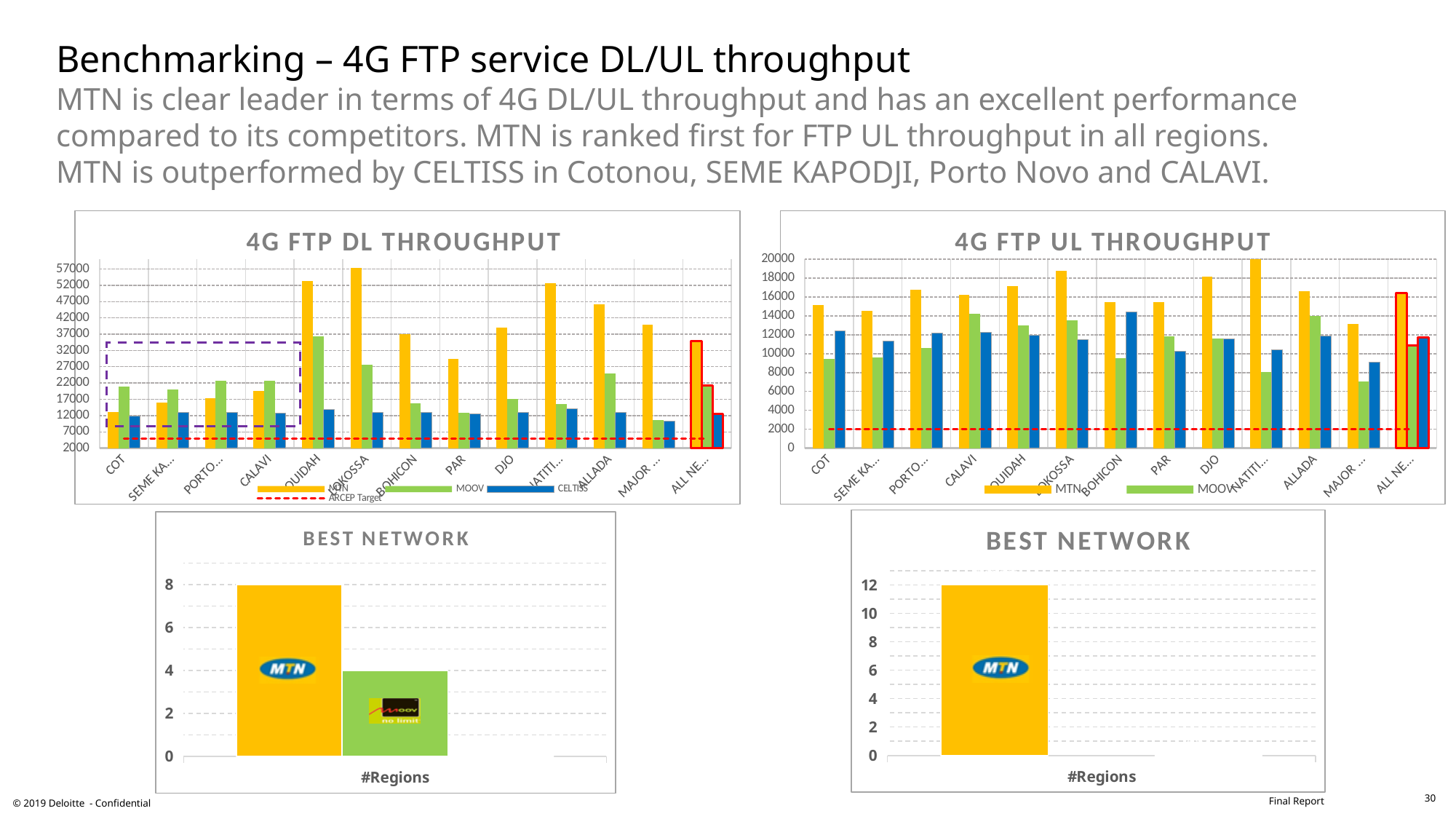
How many regions (categories) are shown on the x axis of the 4G FTP DL THROUGHPUT chart? 13 In the 4G FTP DL THROUGHPUT chart, is the MTN value for OUIDAH greater or less than 47000? greater In the 4G FTP UL THROUGHPUT chart, is the MTN value for DJO greater or less than 16000? greater In the 4G FTP DL THROUGHPUT chart, which region has the highest MTN bar? LOKOSSA In the bottom-right BEST NETWORK chart, what is the value of the MTN bar? 12 How many entries does the legend of the 4G FTP DL THROUGHPUT chart list? 4 In the bottom-left BEST NETWORK chart, what is the value of the MTN bar? 8 In the bottom-left BEST NETWORK chart, what is the difference between the MTN and MOOV bars? 4 What kind of chart is the bottom-left BEST NETWORK chart? Bar chart In the 4G FTP UL THROUGHPUT chart, for COT, which is larger: the MTN bar or the CELTISS bar? MTN In the bottom-left BEST NETWORK chart, what is the value of the MOOV bar? 4 In the 4G FTP DL THROUGHPUT chart, for COT, which is larger: the MTN bar or the MOOV bar? MOOV